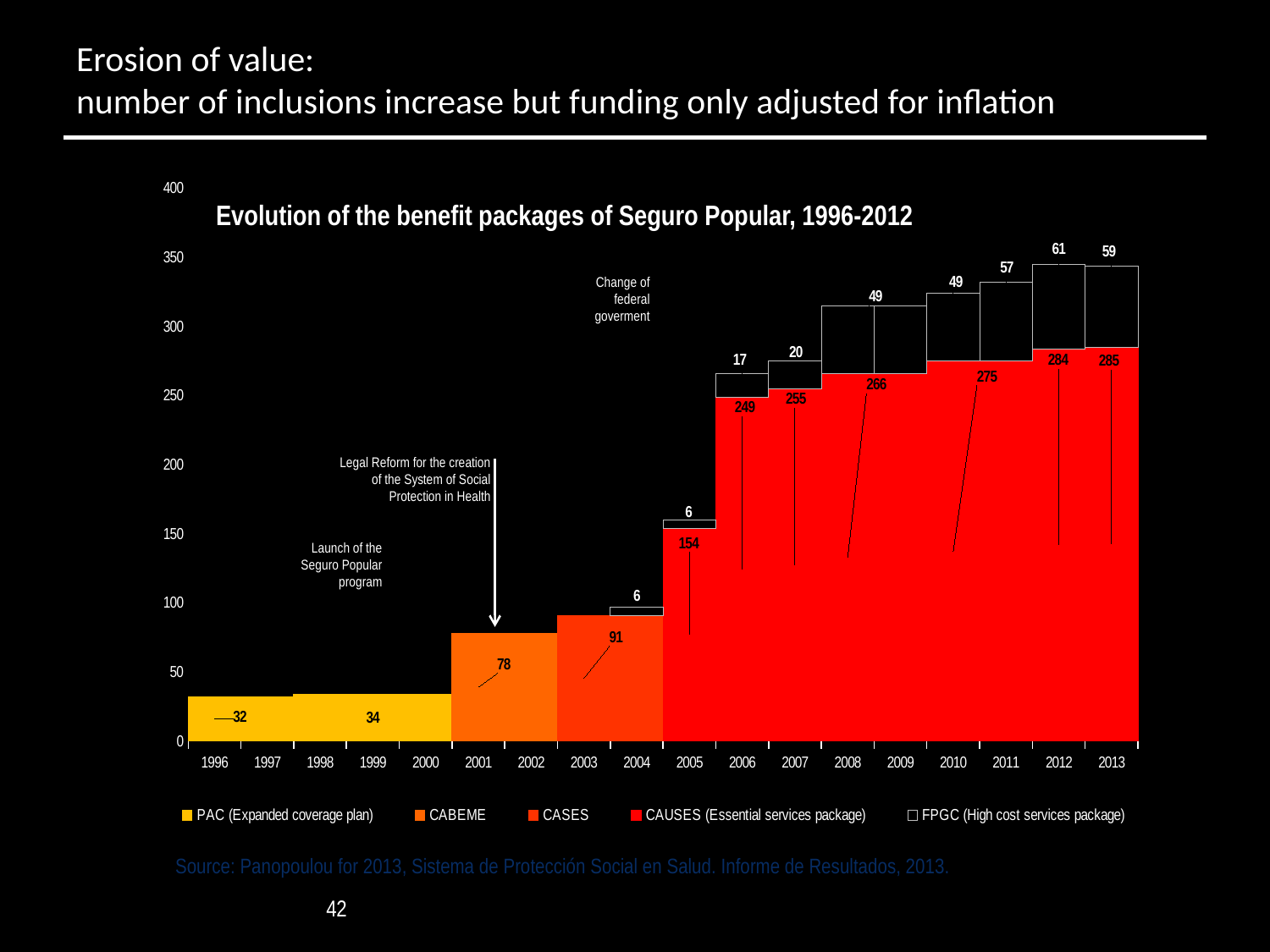
What is the value of CAUSES (Essential services package) in 2013? 285 What is the total of the stacked bar for 2012? 345 What kind of chart is shown on the slide? Stacked bar chart What is the title of the chart? Evolution of the benefit packages of Seguro Popular, 1996-2012 How many series does the legend list? 5 What is the value labelled for CASES? 91 Is the FPGC value larger in 2006 or in 2007? 2007 What is the value labelled for CABEME? 78 What is the value of FPGC (High cost services package) in 2012? 61 In which year is the FPGC (High cost services package) value highest? 2012 What is the total of the stacked bar for 2013? 344 What is the difference between the CAUSES value in 2006 and in 2005? 95